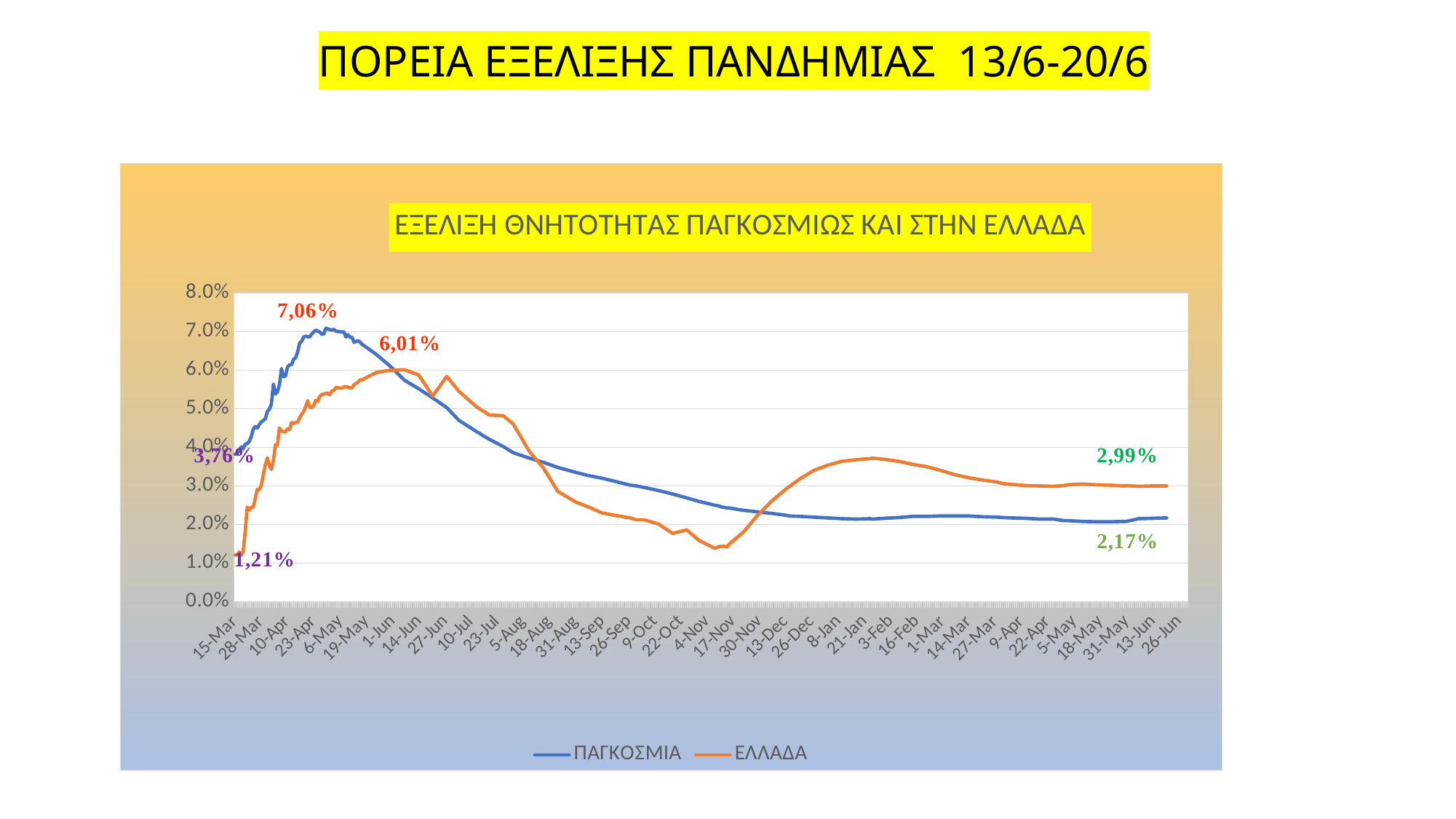
How many series does the chart legend list? 2 What is the final value labelled for ΕΛΛΑΔΑ at the right end of the chart? 2,99% What is the peak value labelled on the ΠΑΓΚΟΣΜΙΑ line? 7,06% What is the final value labelled for ΠΑΓΚΟΣΜΙΑ at the right end of the chart? 2,17% At the right end of the chart, which series has the higher value, ΠΑΓΚΟΣΜΙΑ or ΕΛΛΑΔΑ? ΕΛΛΑΔΑ What is the difference between the labelled peak of ΠΑΓΚΟΣΜΙΑ (7,06%) and the labelled peak of ΕΛΛΑΔΑ (6,01%)? 1,05% Is the value of the ΕΛΛΑΔΑ line around 17-Nov greater or less than 2.0%? less What is the title of the chart? ΕΞΕΛΙΞΗ ΘΝΗΤΟΤΗΤΑΣ ΠΑΓΚΟΣΜΙΩΣ ΚΑΙ ΣΤΗΝ ΕΛΛΑΔΑ Which series is drawn in orange? ΕΛΛΑΔΑ What kind of chart is shown on the slide? line chart What is the peak value labelled on the ΕΛΛΑΔΑ line? 6,01% From its peak in May to the end of the chart, does the ΠΑΓΚΟΣΜΙΑ line rise or fall overall? fall